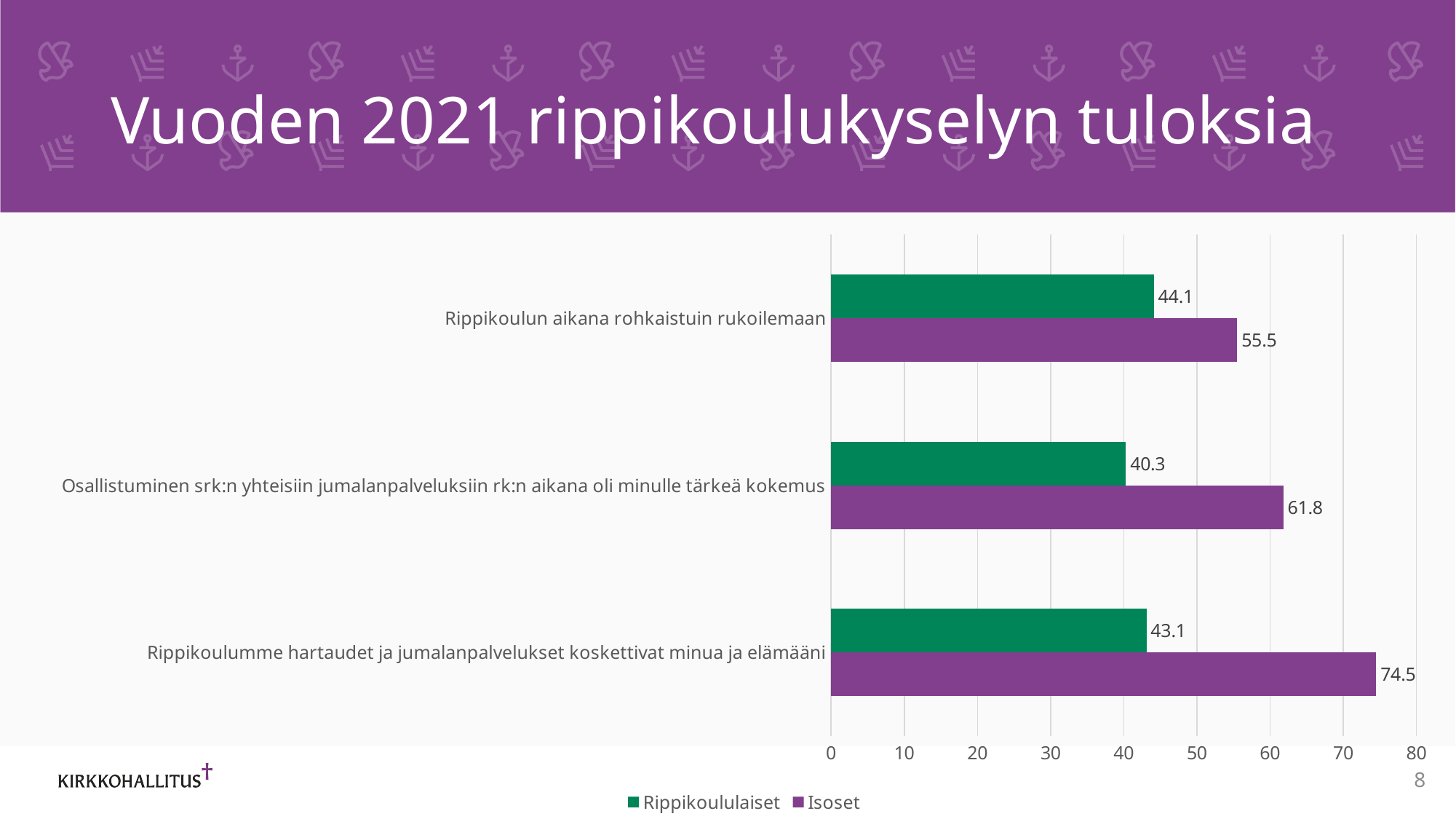
What colour are the Isoset bars? Purple What is the value for Isoset for "Rippikoulumme hartaudet ja jumalanpalvelukset koskettivat minua ja elämääni"? 74.5 How many categories are shown on the chart? 3 What is the value for Isoset for "Osallistuminen srk:n yhteisiin jumalanpalveluksiin rk:n aikana oli minulle tärkeä kokemus"? 61.8 Which category has the lowest Rippikoululaiset value? Osallistuminen srk:n yhteisiin jumalanpalveluksiin rk:n aikana oli minulle tärkeä kokemus What is the value for Rippikoululaiset for "Rippikoulun aikana rohkaistuin rukoilemaan"? 44.1 Which category has the highest Isoset value? Rippikoulumme hartaudet ja jumalanpalvelukset koskettivat minua ja elämääni How many series does the legend list? 2 Is the Isoset value for "Osallistuminen srk:n yhteisiin jumalanpalveluksiin rk:n aikana oli minulle tärkeä kokemus" greater or less than 60? greater What is the difference between the Isoset and Rippikoululaiset values for "Rippikoulumme hartaudet ja jumalanpalvelukset koskettivat minua ja elämääni"? 31.4 Which is larger for "Rippikoulun aikana rohkaistuin rukoilemaan": the Rippikoululaiset value or the Isoset value? Isoset What kind of chart is shown on the slide? Bar chart